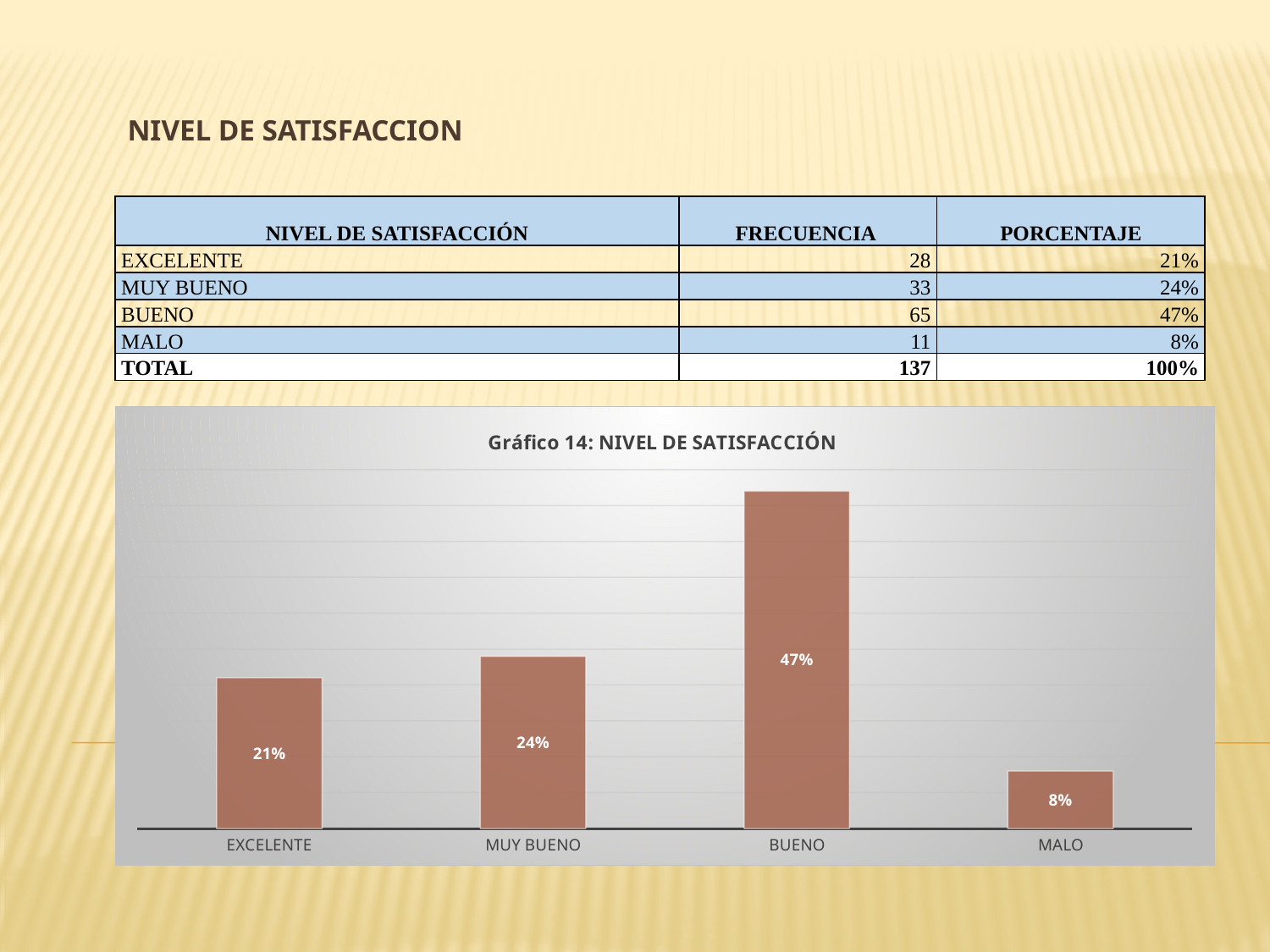
What is the title of the chart? Gráfico 14: NIVEL DE SATISFACCIÓN What is the value shown for BUENO in the chart? 47% Which is larger, the value for EXCELENTE or the value for MUY BUENO? MUY BUENO What is the difference between the values for EXCELENTE and MALO? 13% What is the value shown for MUY BUENO in the chart? 24% What is the value shown for EXCELENTE in the chart? 21% What type of chart is shown on the slide? Bar chart What is the value shown for MALO in the chart? 8% Which category has the highest value in the chart? BUENO How many categories are shown on the x axis of the chart? 4 Which category has the lowest value in the chart? MALO What is the difference between the values for BUENO and MUY BUENO? 23%